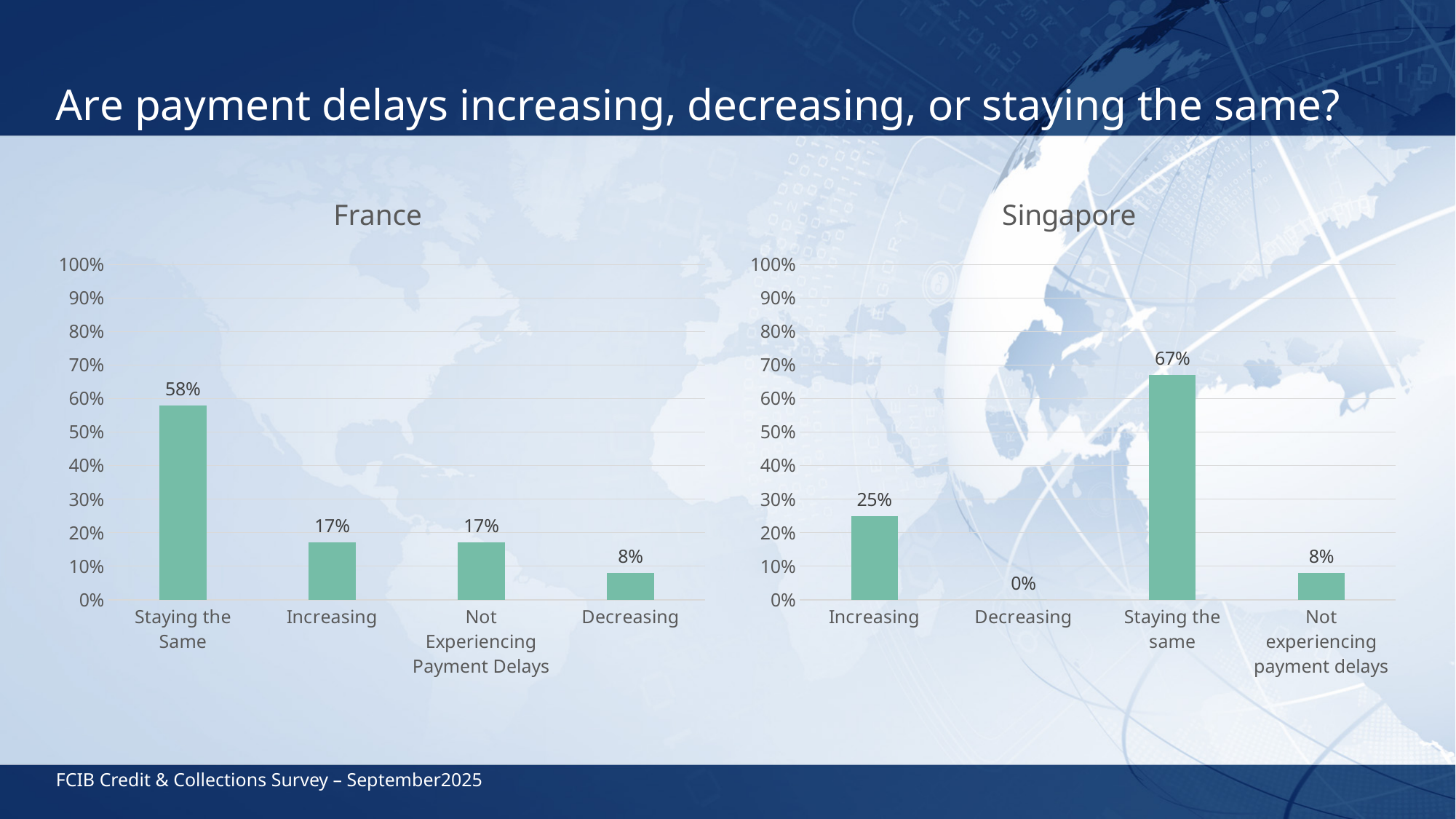
In the France chart, how many categories are shown? 4 In the Singapore chart, which category has the highest value? Staying the same In the France chart, which category has the lowest value? Decreasing In the Singapore chart, what is the difference between Staying the same and Increasing? 42% What type of chart is the Singapore chart? Bar chart In the France chart, what is the difference between Staying the Same and Increasing? 41% What is the title of the chart on the left? France In the France chart, what is the value for Staying the Same? 58% In the Singapore chart, what is the value for Increasing? 25% In the Singapore chart, what is the value for Decreasing? 0% In the France chart, what is the value for Decreasing? 8% Which is larger: Staying the Same in the France chart or Staying the same in the Singapore chart? Singapore